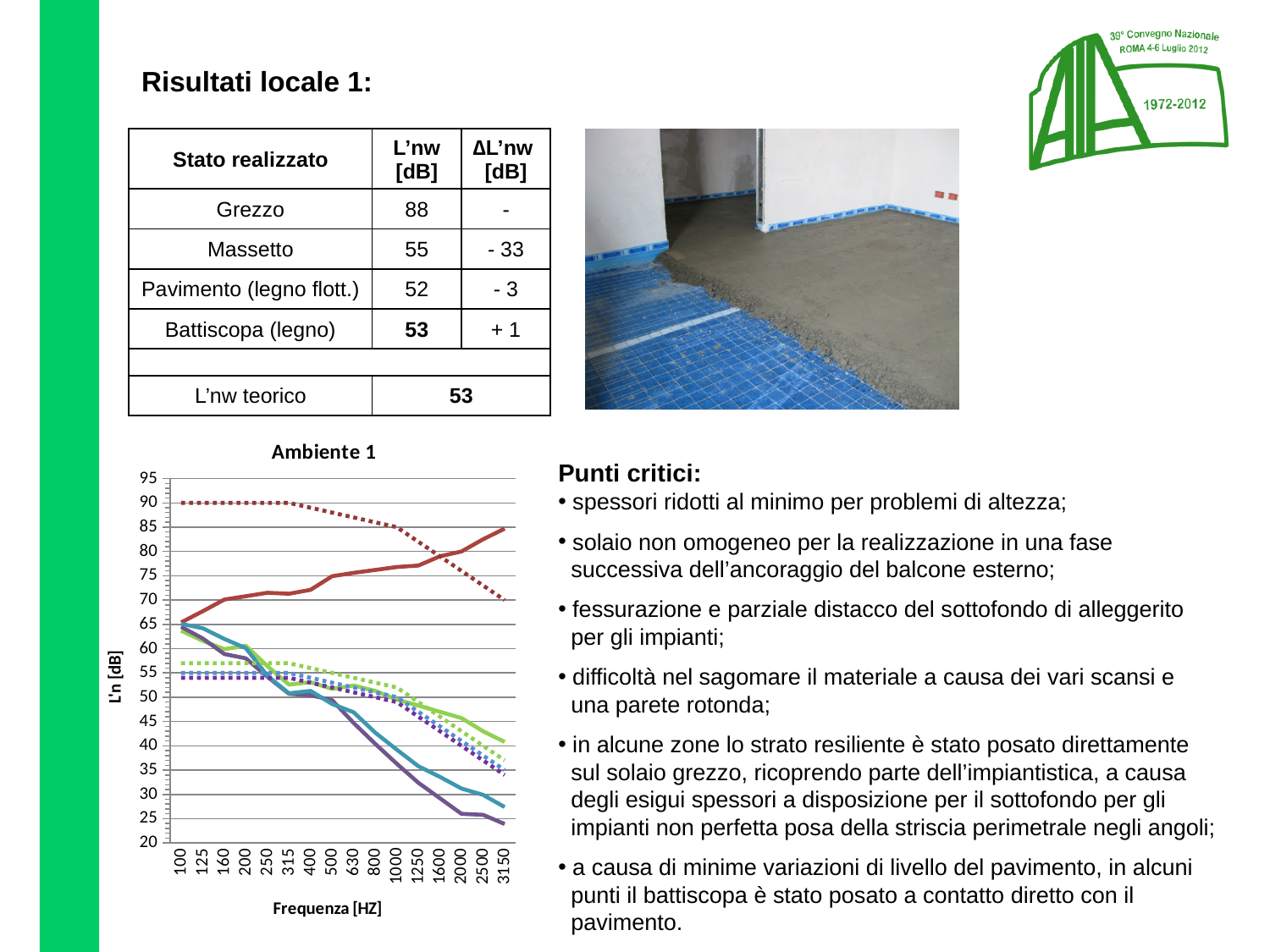
What kind of chart is the "Ambiente 1" chart? line chart In the "Ambiente 1" chart, does the solid purple line rise or fall as frequency increases? falls In the "Ambiente 1" chart, at 3150 Hz, which is higher: the solid red line or the solid purple line? solid red line In the "Ambiente 1" chart, is the value of the dotted red line at 3150 Hz greater or less than 75? less What is the label of the x axis of the "Ambiente 1" chart? Frequenza [HZ] In the "Ambiente 1" chart, is the value of the solid purple line at 3150 Hz greater or less than 30? less How many frequency values are shown on the x axis of the "Ambiente 1" chart? 16 In the "Ambiente 1" chart, is the value of the dotted red line at 100 Hz greater or less than 85? greater In the "Ambiente 1" chart, does the dotted red line rise or fall as frequency increases? falls In the "Ambiente 1" chart, does the solid red line rise or fall as frequency increases? rises What is the title of the line chart on the slide? Ambiente 1